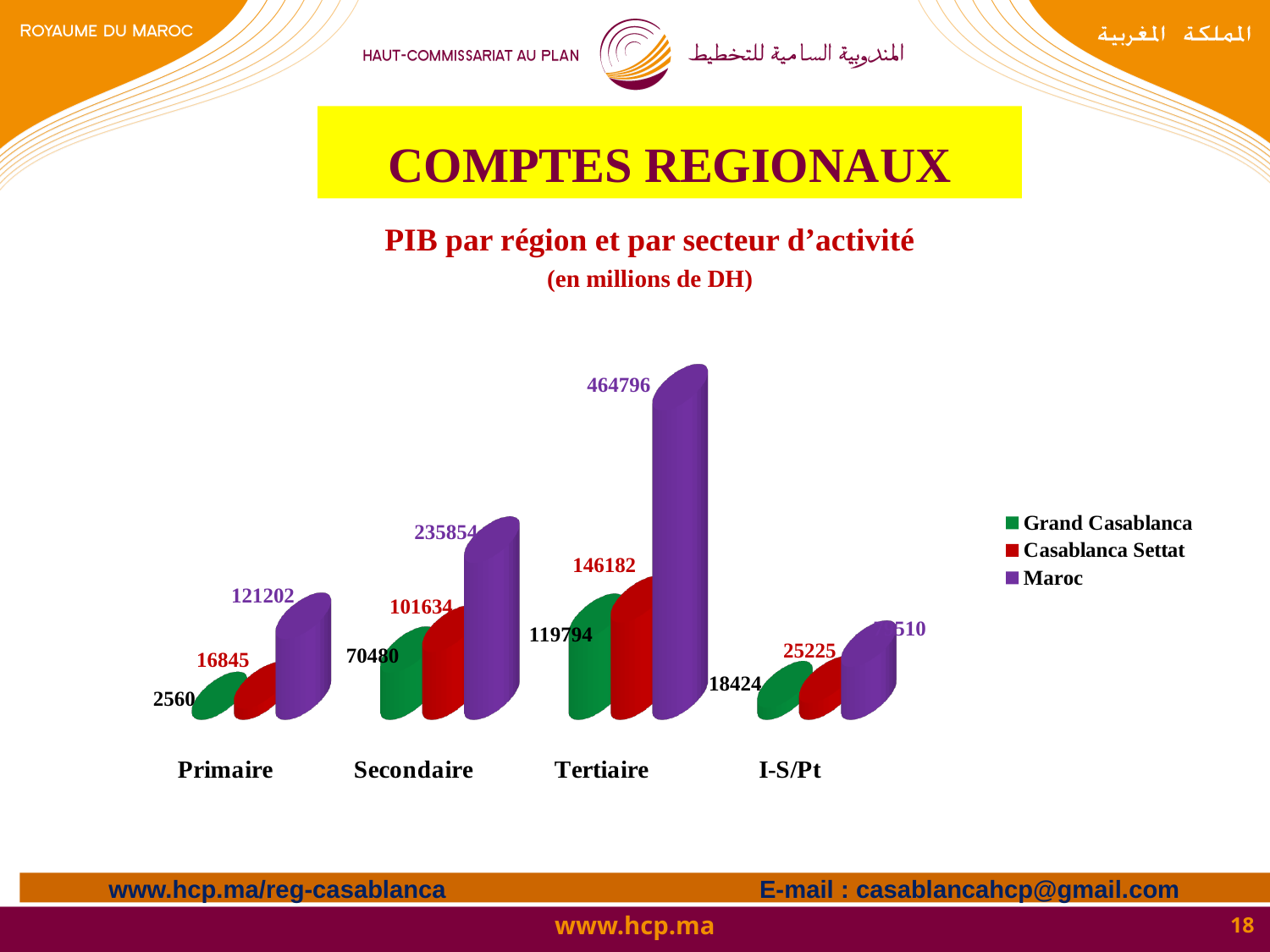
Which sector has the highest value for Maroc? Tertiaire In the Secondaire sector, how much larger is the Maroc value than the Casablanca Settat value? 134220 How many series does the legend list? 3 Which is larger: Grand Casablanca in Tertiaire or Casablanca Settat in Secondaire? Grand Casablanca in Tertiaire What is the value for Casablanca Settat in the Primaire sector? 16845 What is the value for Maroc in the Tertiaire sector? 464796 How many sector categories are shown on the x axis? 4 What is the value for Casablanca Settat in the I-S/Pt category? 25225 What kind of chart is shown on the slide? Bar chart In the Tertiaire sector, what is the difference between the Casablanca Settat value and the Grand Casablanca value? 26388 What is the value for Grand Casablanca in the Secondaire sector? 70480 Which sector has the lowest value for Grand Casablanca? Primaire